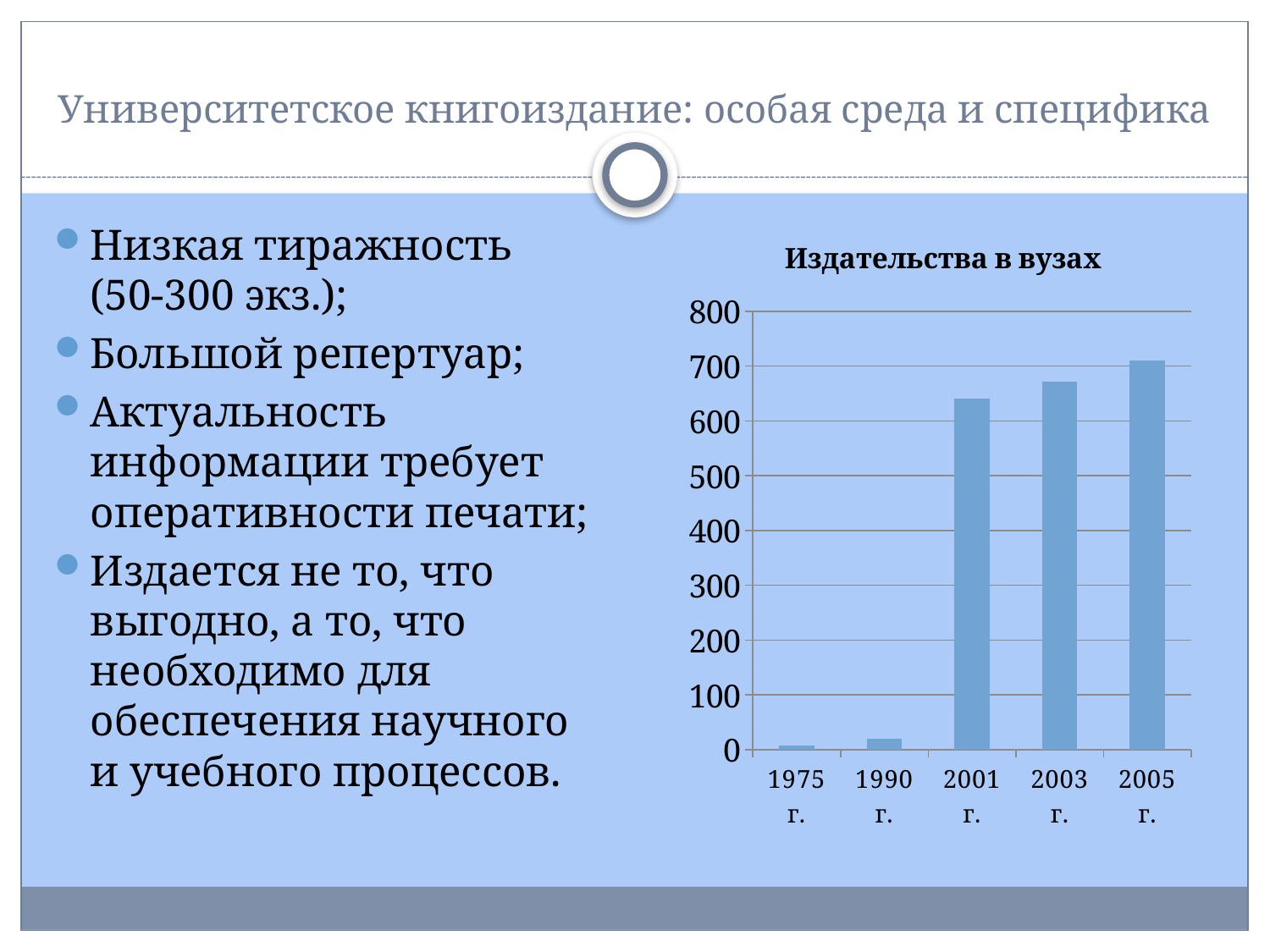
Do the values rise or fall from 1975 г. to 2005 г.? rise What kind of chart is shown on the slide? bar chart Is the value for 2005 г. greater or less than 700? greater What is the title of the chart? Издательства в вузах How many categories (years) are shown on the x axis of the chart? 5 Which is larger, the value for 1990 г. or the value for 2001 г.? 2001 г. Which year has the highest value in the chart? 2005 г. Which year has the lowest value in the chart? 1975 г. What is the highest tick value shown on the vertical axis of the chart? 800 Is the value for 1990 г. greater or less than 100? less Is the value for 2001 г. greater or less than 600? greater